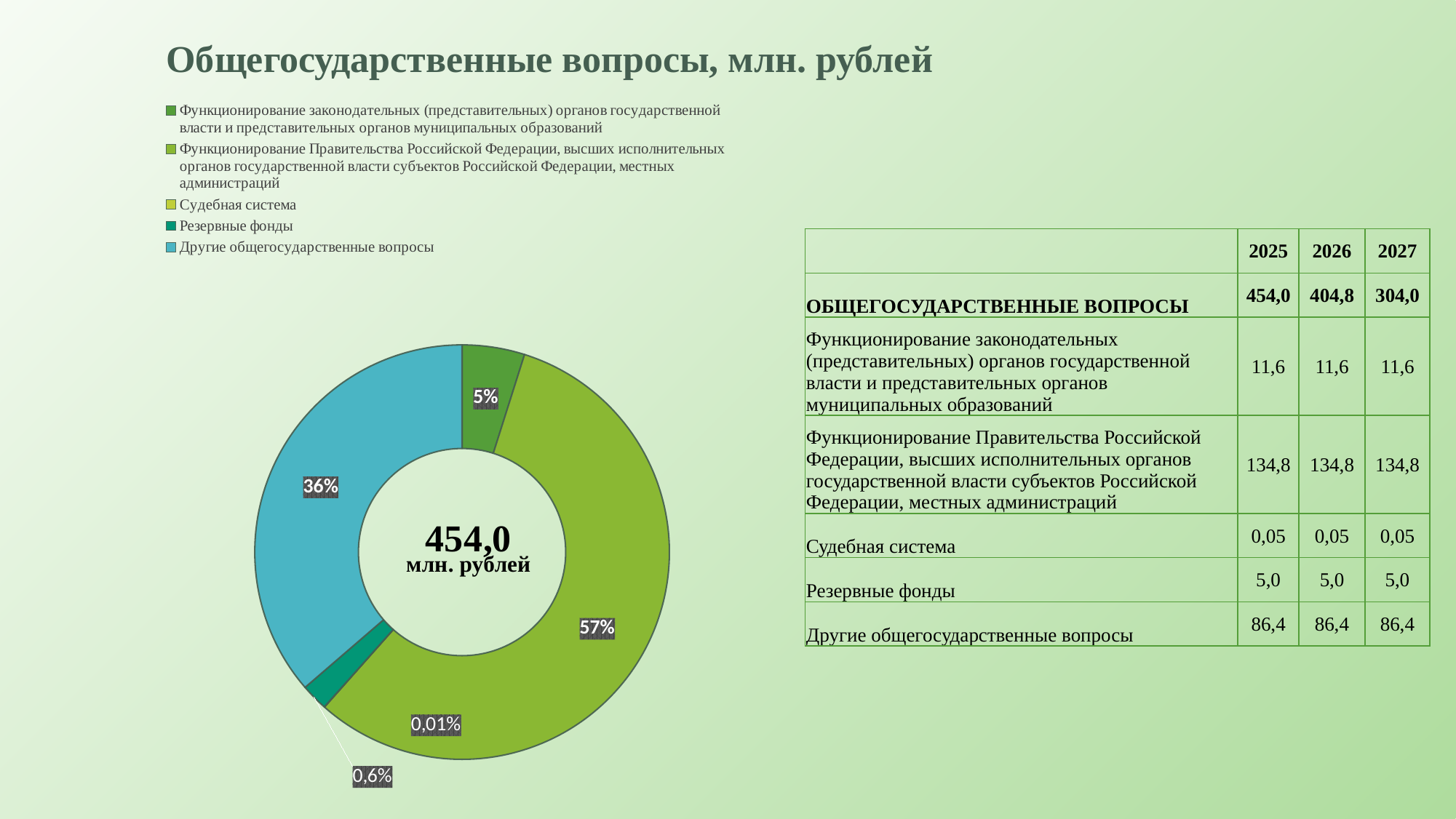
Which category has the largest slice in the donut chart? Функционирование Правительства Российской Федерации, высших исполнительных органов государственной власти субъектов Российской Федерации, местных администраций What share of the donut chart does "Функционирование законодательных (представительных) органов государственной власти и представительных органов муниципальных образований" take? 5% Which category has the smallest slice in the donut chart? Судебная система Which slice is larger in the donut chart: "Другие общегосударственные вопросы" or "Резервные фонды"? Другие общегосударственные вопросы What kind of chart is shown on the slide? Donut (pie) chart What total value is printed in the centre of the donut chart? 454,0 млн. рублей What is the title of the chart on the slide? Общегосударственные вопросы, млн. рублей How many categories does the legend of the donut chart list? 5 What share of the donut chart does "Судебная система" take? 0,01% What share of the donut chart does "Другие общегосударственные вопросы" take? 36%